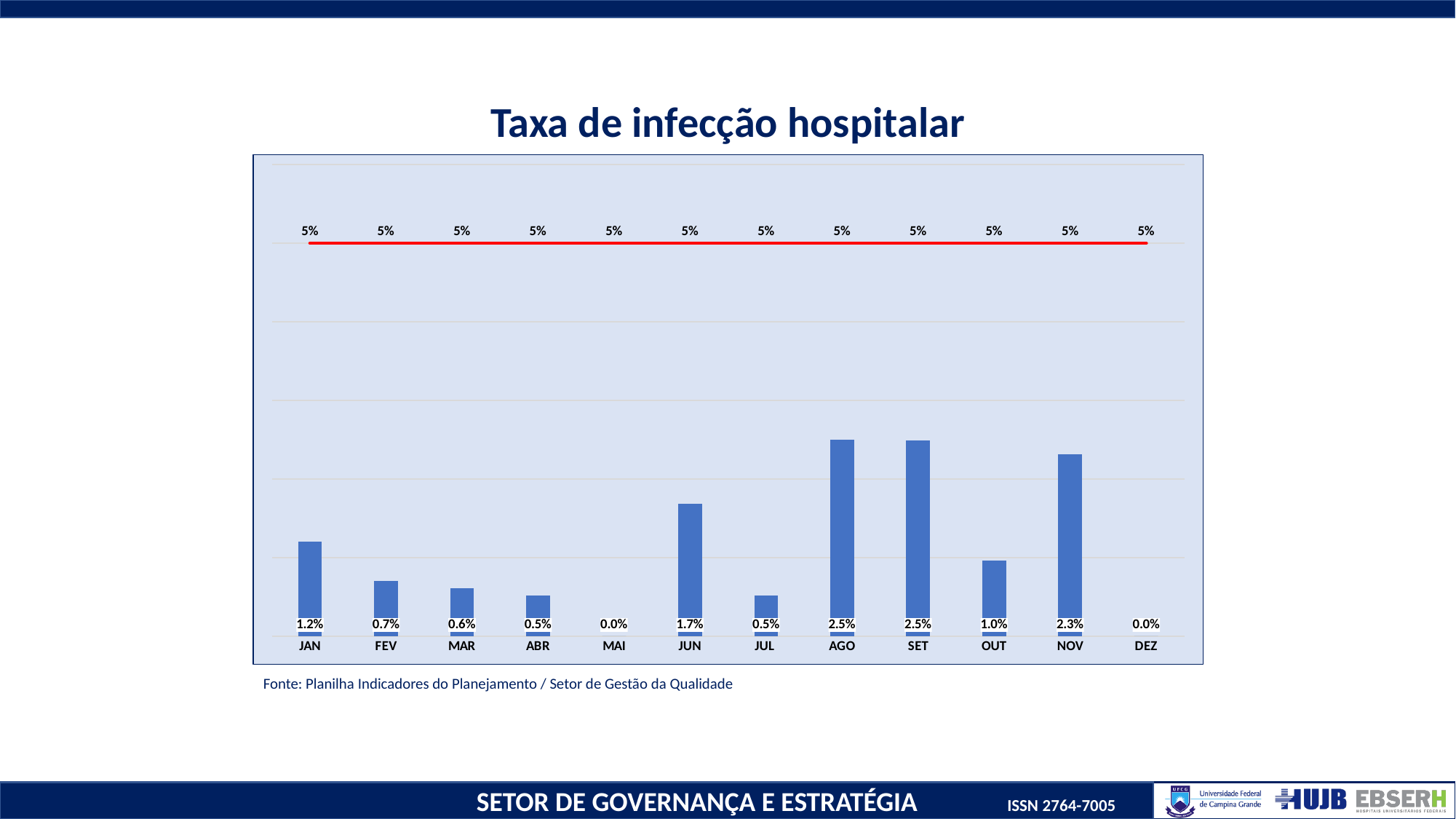
How many months are shown on the x axis? 12 What is the difference between the values for NOV and OUT? 1.3% What is the value of the bar for AGO? 2.5% Which month has the larger value, JAN or FEV? JAN What is the difference between the values for JUN and JUL? 1.2% What type of chart is shown on the slide? Combination bar and line chart What is the hospital infection rate shown for JAN? 1.2% What is the value shown for NOV? 2.3% Which month has the larger value, JUN or NOV? NOV What is the highest monthly value plotted on the chart? 2.5% What value does the red line across the chart represent? 5% What is the value shown for MAI? 0.0%